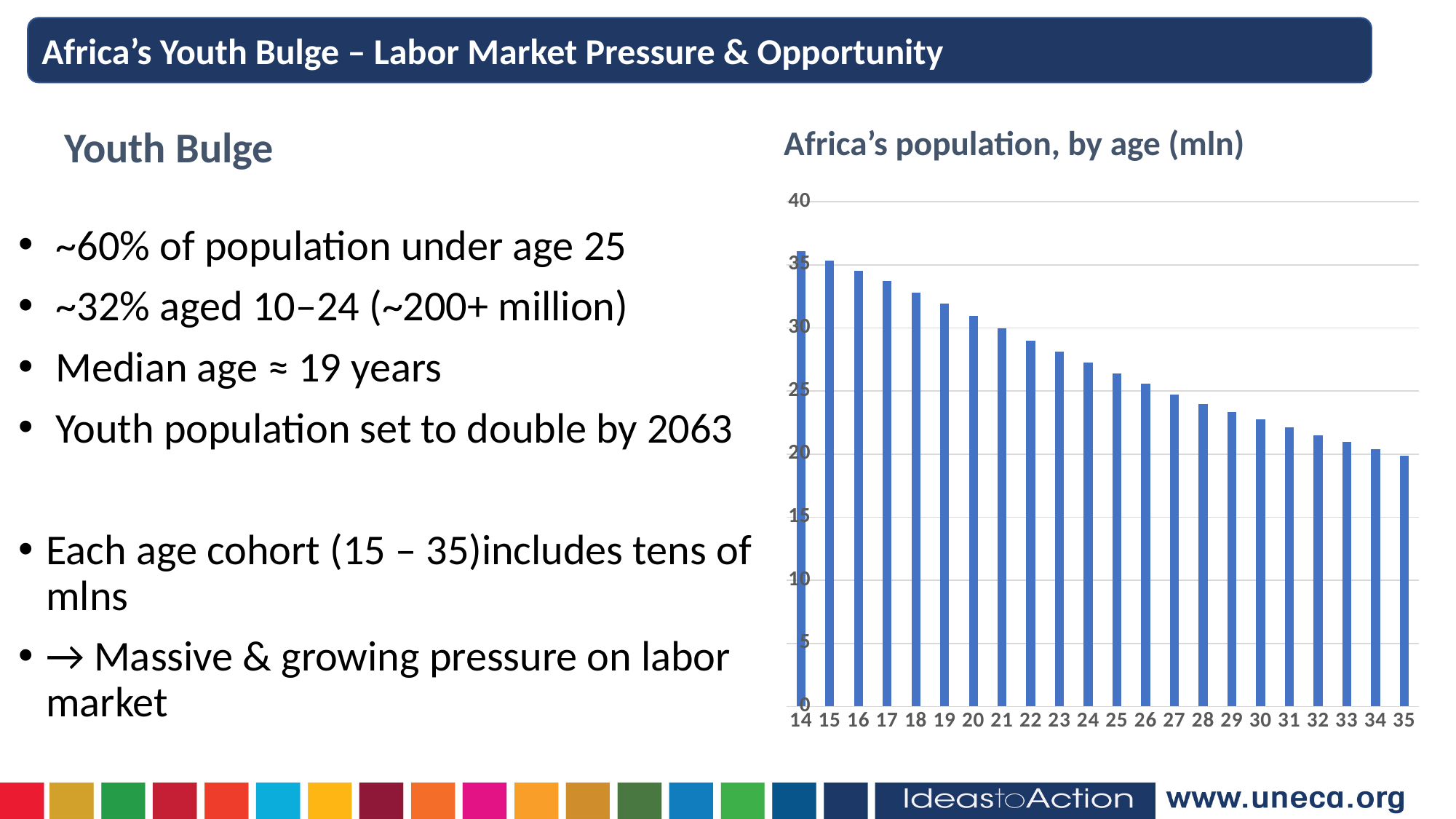
Is the value for age 34 greater or less than 25? less Which age has the lowest population in the chart? 35 Is the value for age 17 greater or less than 30? greater Which age has the highest population in the chart? 14 Is the value for age 30 greater or less than 25? less What kind of chart is shown on the slide? bar chart Which has a larger population, age 15 or age 30? 15 Do the values rise or fall as age increases along the x axis? fall What colour are the bars in the chart? blue What is the title of the chart? Africa's population, by age (mln) How many age categories are plotted on the x axis of the chart? 22